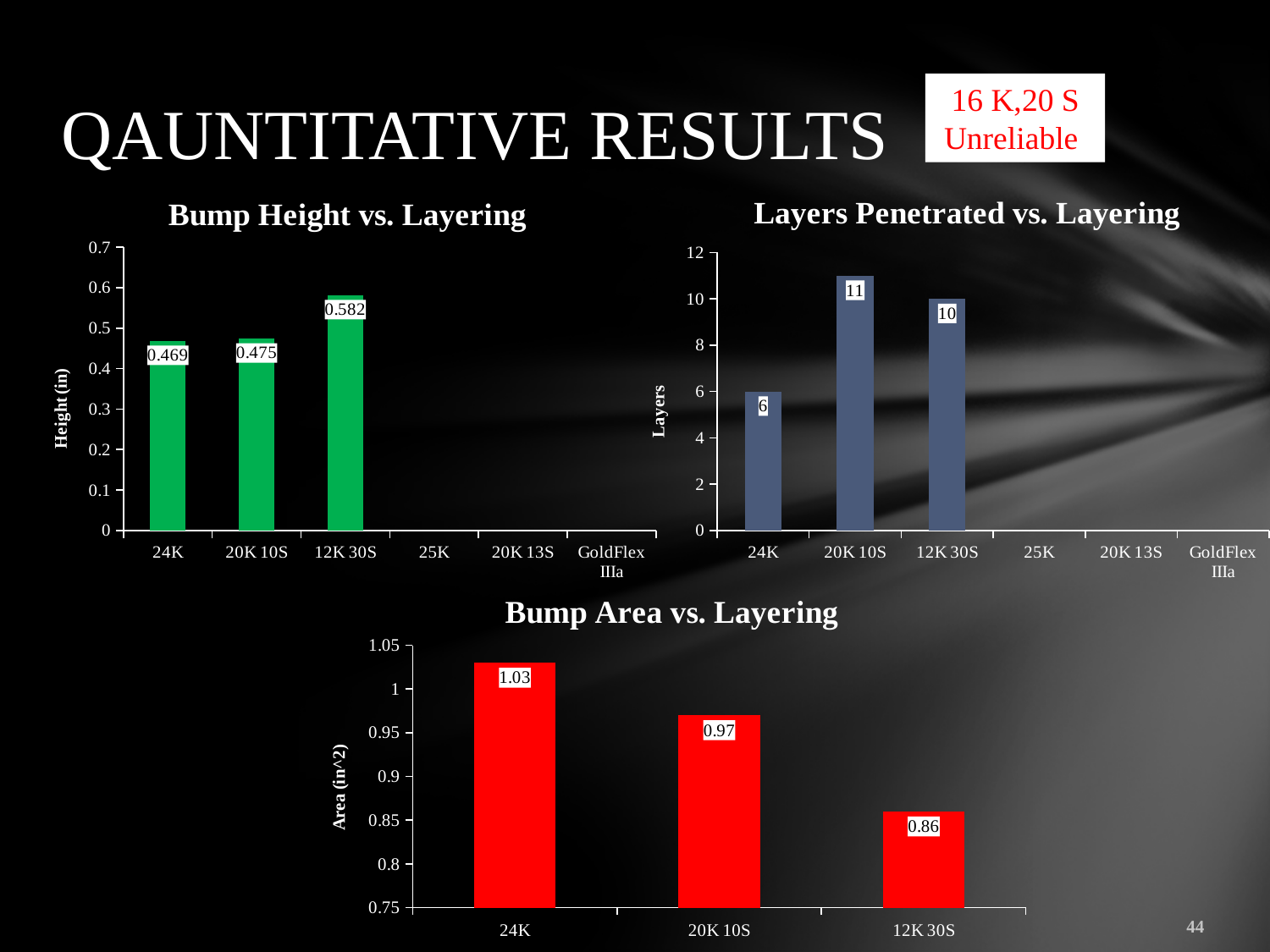
In the Layers Penetrated vs. Layering chart, which category has the lowest number of layers penetrated? 24K In the Bump Height vs. Layering chart, what is the difference between the values for 12K 30S and 24K? 0.113 In the Layers Penetrated vs. Layering chart, how many layers were penetrated for 24K? 6 In the Bump Area vs. Layering chart, do the values rise or fall from left to right along the x axis? fall In the Bump Area vs. Layering chart, how many categories are shown on the x axis? 3 In the Bump Area vs. Layering chart, which category has the lowest bump area? 12K 30S In the Bump Area vs. Layering chart, what is the bump area for 20K 10S? 0.97 In the Bump Height vs. Layering chart, what is the bump height for 12K 30S? 0.582 In the Layers Penetrated vs. Layering chart, what is the difference between the values for 20K 10S and 24K? 5 In the Bump Height vs. Layering chart, which category has the highest bump height? 12K 30S In the Layers Penetrated vs. Layering chart, which category has the highest number of layers penetrated? 20K 10S What kind of chart is the Bump Height vs. Layering chart? bar chart